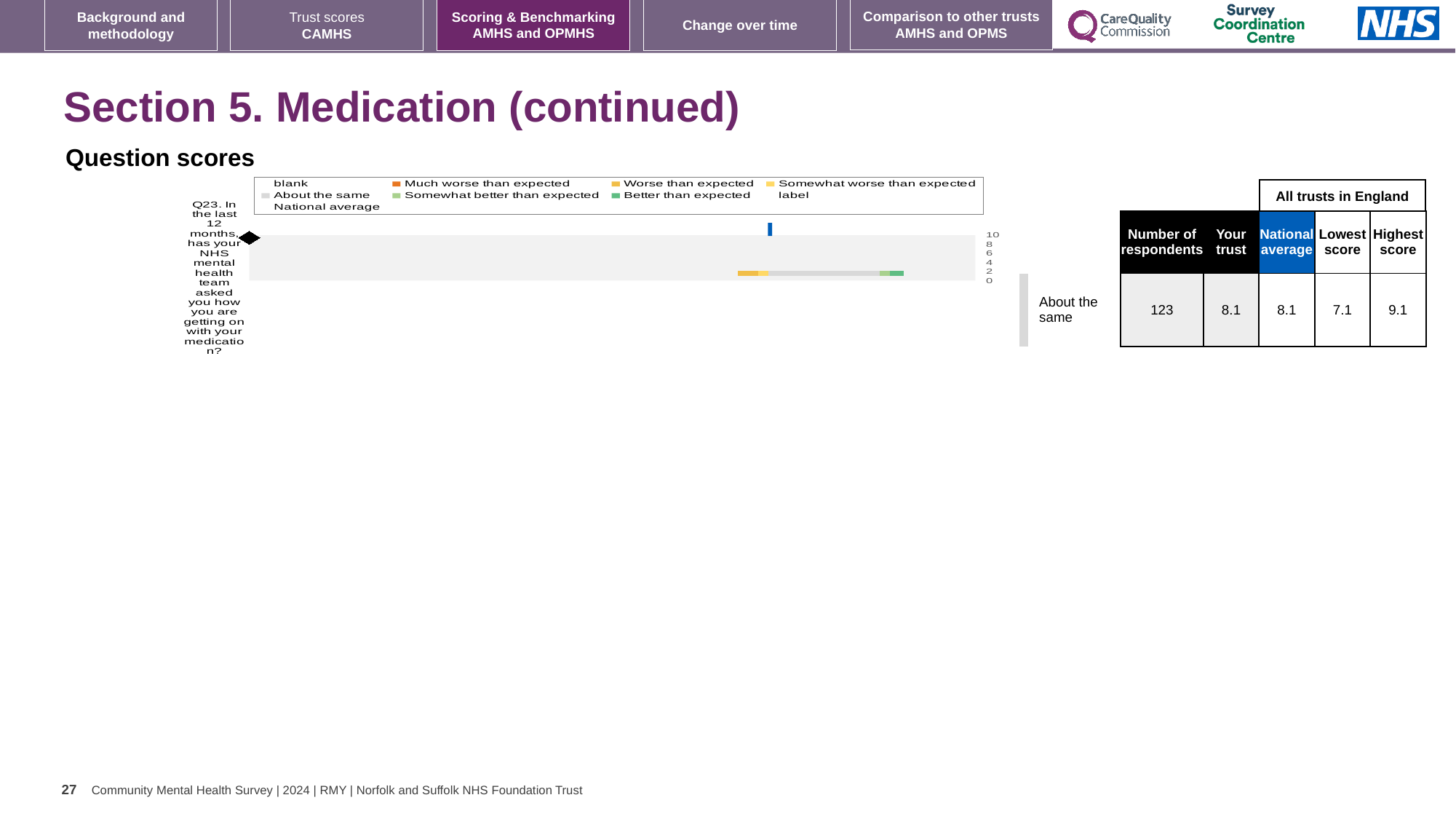
What is the national average score for Q23 in the table next to the chart? 8.1 Which is larger for Q23, the 'Your trust' score or the lowest score? Your trust What is the highest score among all trusts in England for Q23? 9.1 How many entries does the chart legend list? 9 What is the highest value shown on the chart's axis? 10 What is the difference between the highest score and the lowest score for Q23? 2.0 What is the lowest score among all trusts in England for Q23? 7.1 Which question is plotted in the chart? Q23. In the last 12 months, has your NHS mental health team asked you how you are getting on with your medication? How many questions (categories) are plotted in the chart? 1 What kind of chart is shown under 'Question scores'? bar chart How many respondents answered Q23? 123 What is the 'Your trust' score for Q23 in the table next to the chart? 8.1